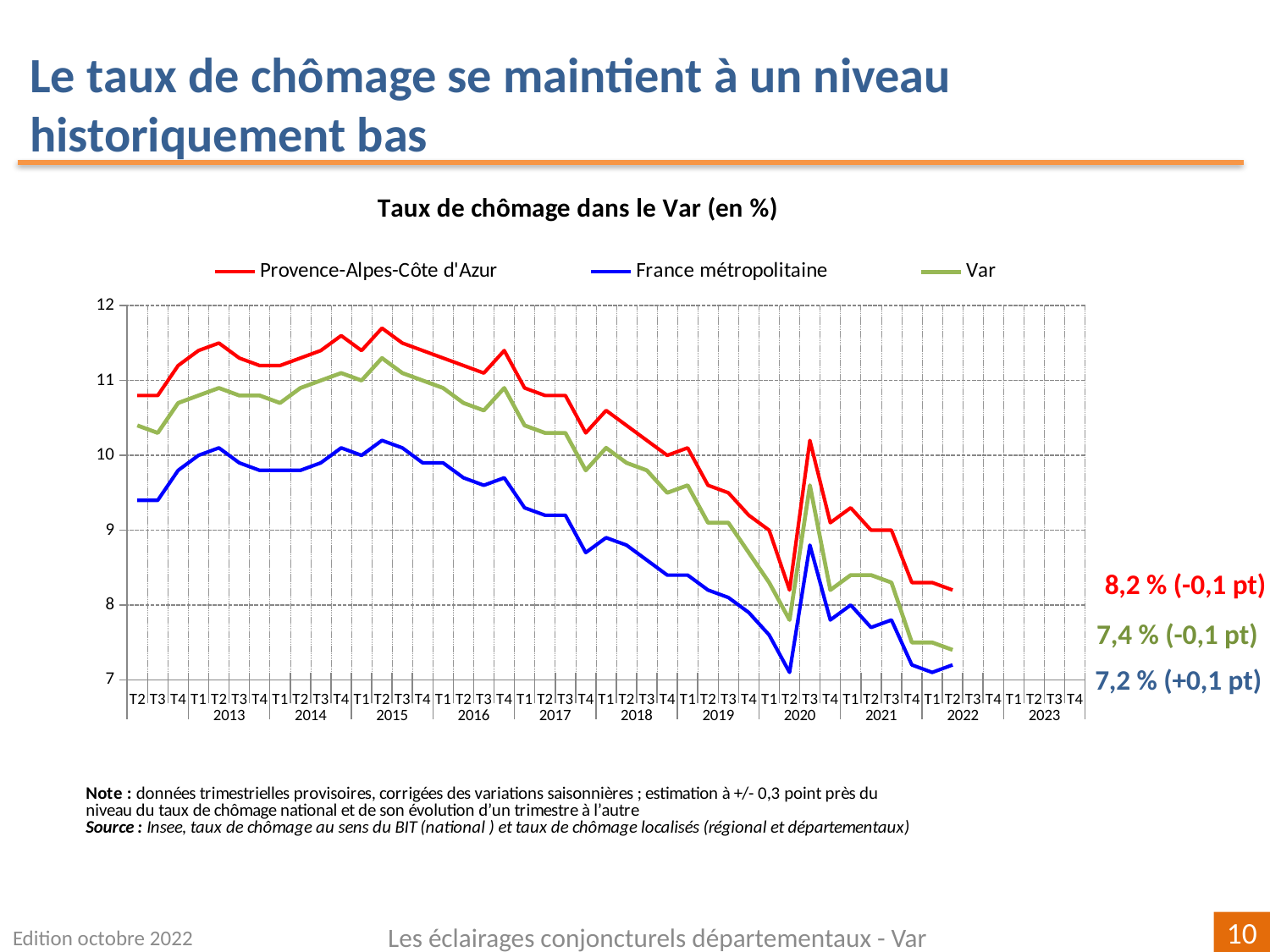
What is the latest unemployment rate shown for Provence-Alpes-Côte d'Azur? 8,2 % What is the latest unemployment rate shown for the Var? 7,4 % Overall, does the Var unemployment rate rise or fall between 2015 and 2022? Fall What is the difference between the latest rates for Provence-Alpes-Côte d'Azur and France métropolitaine? 1,0 pt At the end of the series, which is higher: Provence-Alpes-Côte d'Azur or France métropolitaine? Provence-Alpes-Côte d'Azur What is the latest unemployment rate shown for France métropolitaine? 7,2 % Which series has the highest values across the whole period? Provence-Alpes-Côte d'Azur What kind of chart is shown on the slide? Line chart Is the value for France métropolitaine in T2 2020 greater or less than 8? less Is the value for Provence-Alpes-Côte d'Azur in T2 2015 greater or less than 11? greater How many series does the legend list? 3 By how much did the Var unemployment rate change in the latest quarter, according to the annotation? -0,1 pt